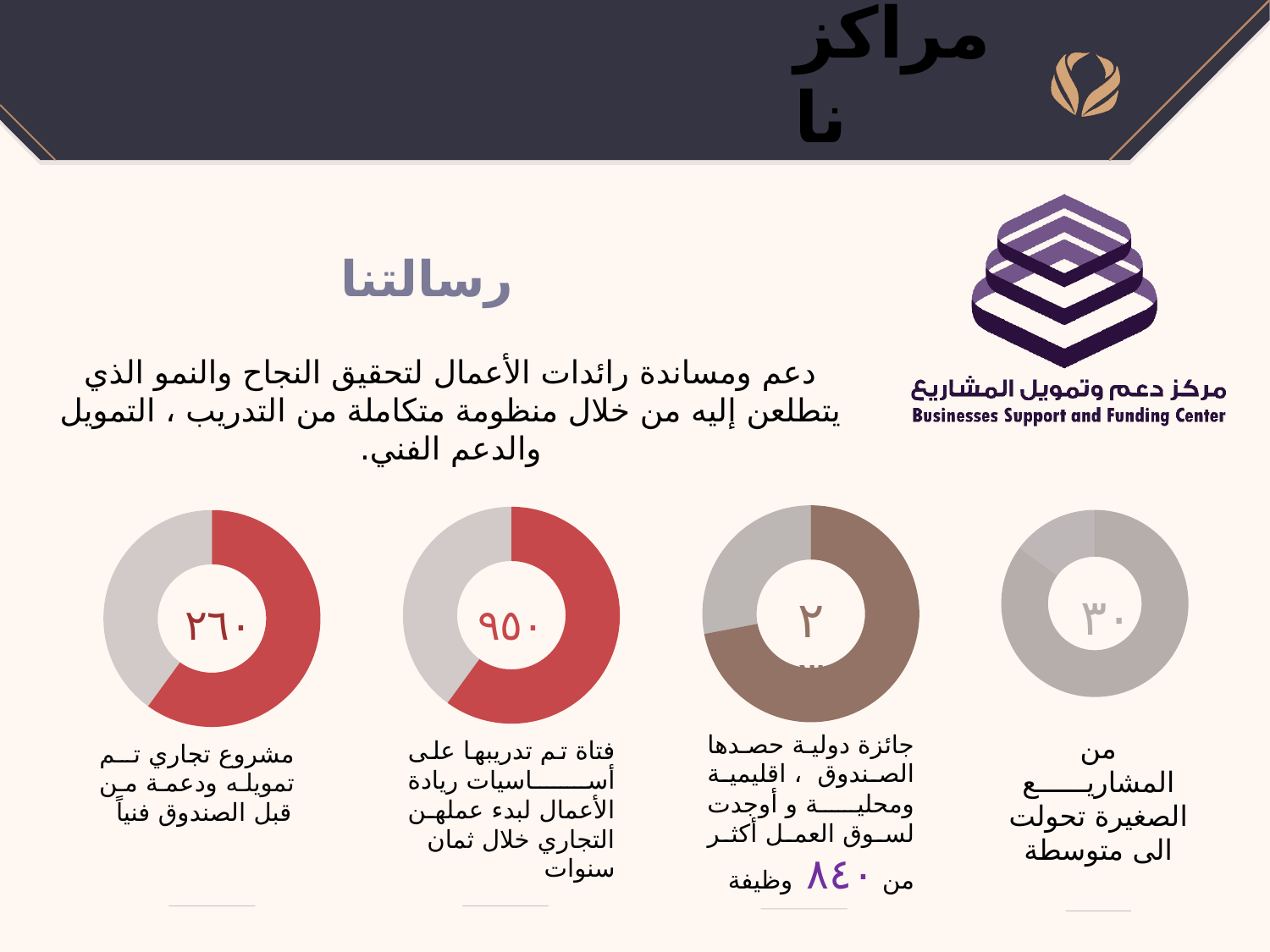
What is the difference between the centre values of the second donut chart from the left and the leftmost donut chart? ٦٩٠ What value is printed in the centre of the second donut chart from the left? ٩٥٠ What value is printed in the centre of the rightmost donut chart? ٣٠ What value is printed in the centre of the third donut chart from the left? ٢ How many donut charts are shown on the slide? 4 What value is printed in the centre of the leftmost donut chart? ٢٦٠ Which donut chart shows the largest centre value? The second from the left (٩٥٠) What kind of chart is used for the four figures at the bottom of the slide? Donut (pie) chart What colour is the filled portion of the leftmost donut chart? Red Which is larger, the centre value of the leftmost donut chart or the rightmost donut chart? The leftmost (٢٦٠) What colour is the filled portion of the third donut chart from the left? Brown Which donut chart shows the smallest centre value? The third from the left (٢)